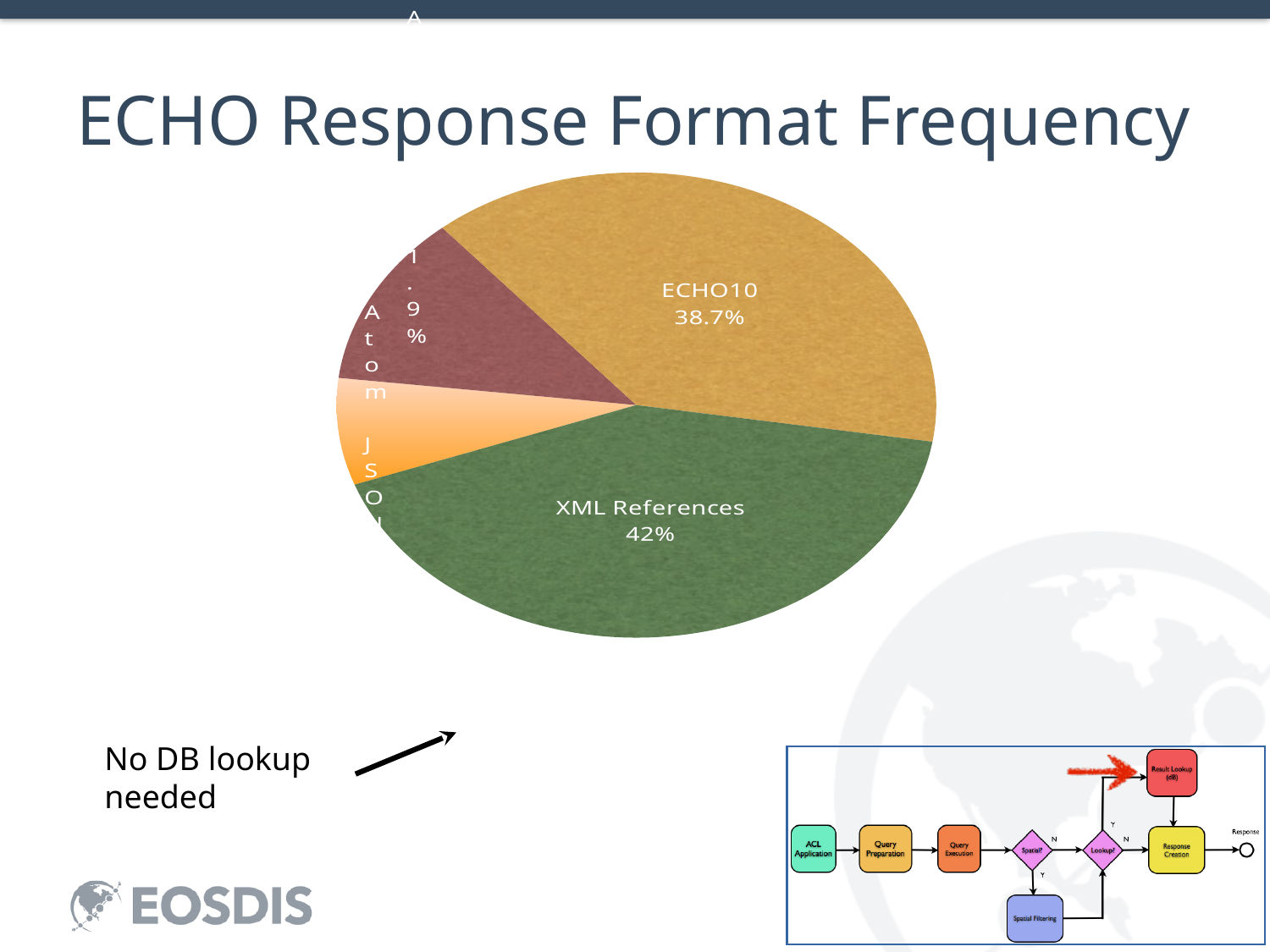
Which is larger, the share for ECHO10 or the share for XML References? XML References Which response format has the smallest slice of the pie? JSON Which response format has the largest share of the pie? XML References Which is larger, the Atom slice or the XML References slice? XML References What percentage of responses use the XML References format? 42% What colour is the ECHO10 slice of the pie? orange/gold What percentage of responses use the ECHO10 format? 38.7% What share of the pie does the XML References slice represent? 42% What is the difference in percentage points between the XML References share and the ECHO10 share? 3.3% What is the title of the chart? ECHO Response Format Frequency What kind of chart is shown on the slide? pie chart How many slices does the pie chart have? 4